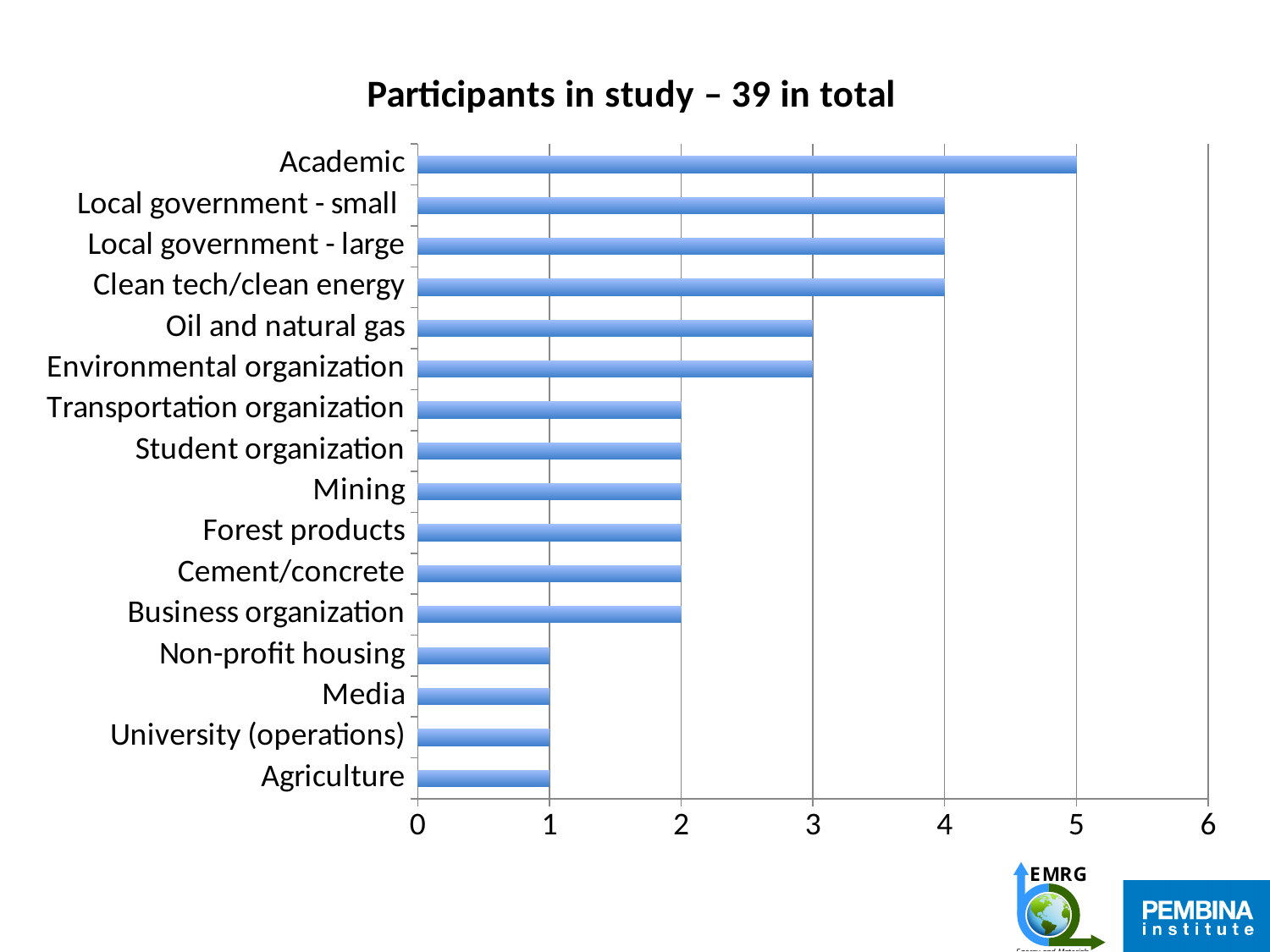
How many participants are in the Oil and natural gas category? 3 What is the difference between the number of participants for Academic and for Clean tech/clean energy? 1 Which has more participants, Environmental organization or Business organization? Environmental organization How many participants are in the Mining category? 2 What is the difference between the number of participants for Transportation organization and for Media? 1 Is the value for Local government - small greater or less than 3? greater How many categories are shown on the chart? 16 What is the title of the chart? Participants in study – 39 in total Which category has the highest number of participants? Academic How many participants are in the Academic category? 5 How many participants are in the Agriculture category? 1 What kind of chart is shown on the slide? Bar chart